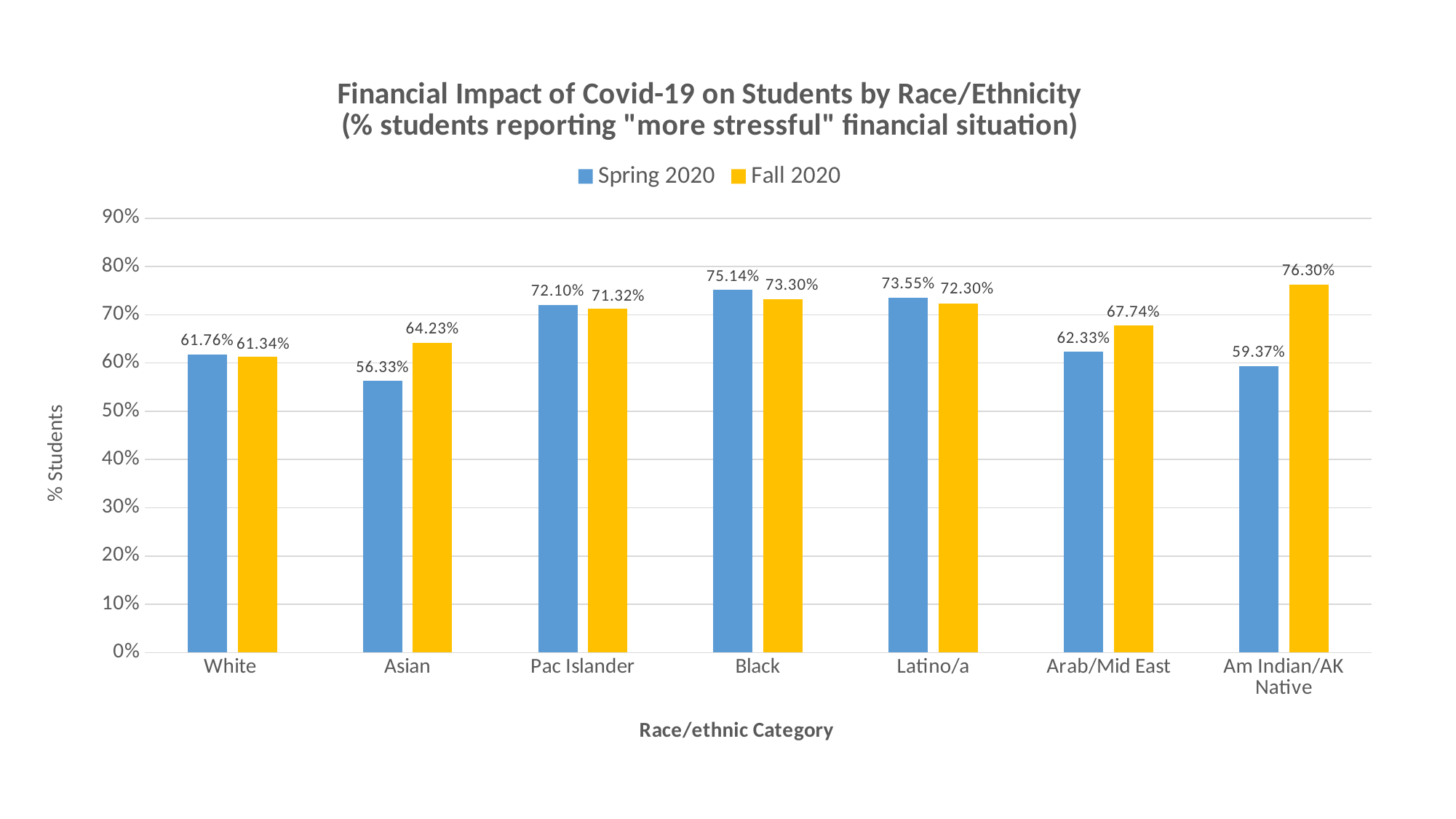
What is the difference between the Fall 2020 and Spring 2020 values for Asian students? 7.90% What is the Fall 2020 value for Am Indian/AK Native students? 76.30% What kind of chart is shown on the slide? bar chart What is the Spring 2020 value for Asian students? 56.33% What is the difference between the Fall 2020 and Spring 2020 values for Am Indian/AK Native students? 16.93% What is the Spring 2020 value for Black students? 75.14% Which is larger for Arab/Mid East students, the Spring 2020 value or the Fall 2020 value? Fall 2020 How many race/ethnic categories are shown on the x axis? 7 How many series does the legend list? 2 Is the Spring 2020 value for White students greater or less than 70%? less Which race/ethnic category has the highest Fall 2020 value? Am Indian/AK Native Which race/ethnic category has the lowest Spring 2020 value? Asian